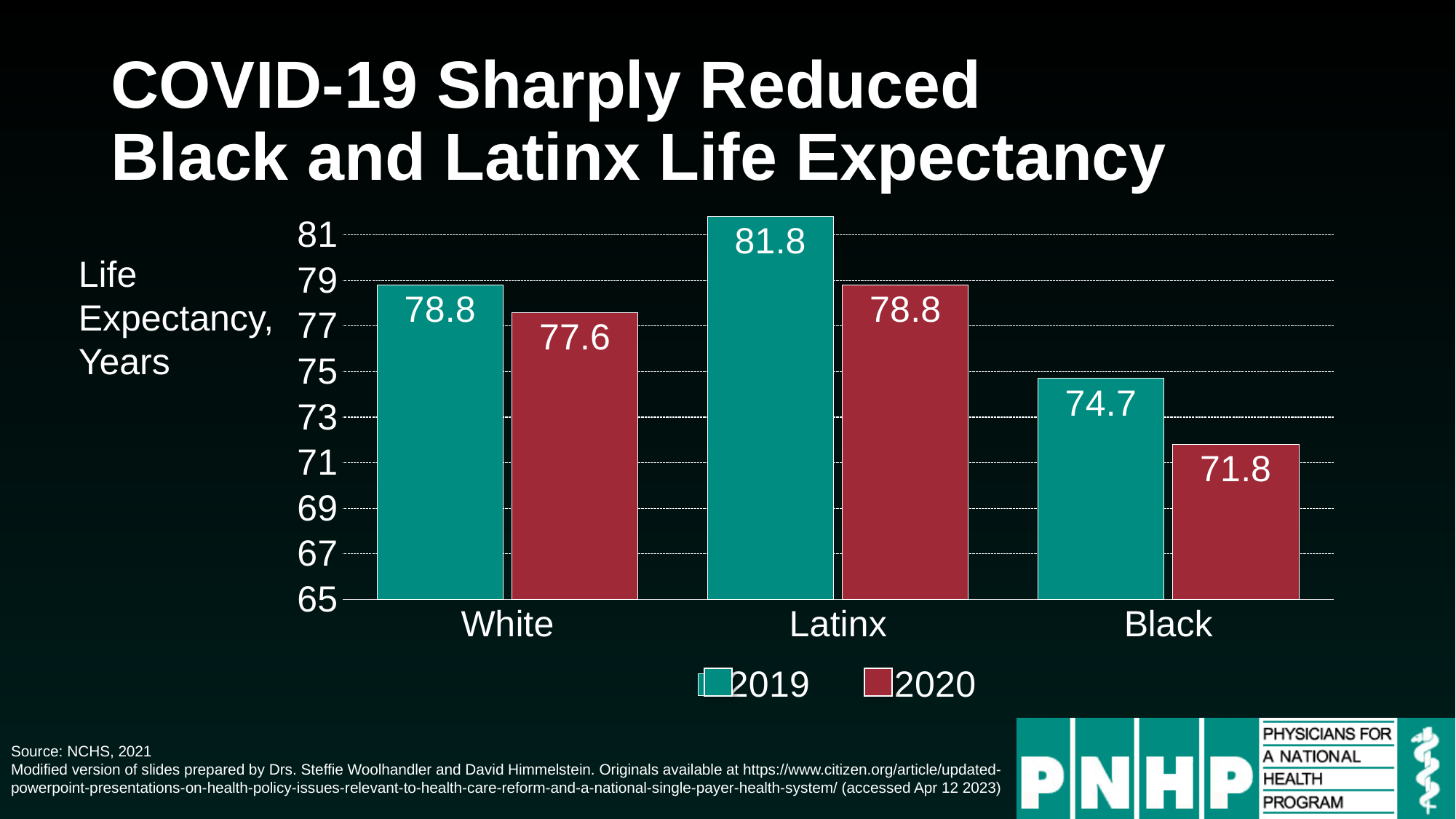
What was the life expectancy for Black people in 2020? 71.8 How many series does the legend list? 2 What kind of chart is shown on the slide? Bar chart What was the life expectancy for Latinx people in 2019? 81.8 By how much did Black life expectancy fall from 2019 to 2020? 2.9 Which group had the highest life expectancy in 2019? Latinx How many groups are shown on the x axis? 3 By how much did Latinx life expectancy fall from 2019 to 2020? 3.0 Which group had the lowest life expectancy in 2020? Black What colour represents the 2020 series? Red What was the life expectancy for White people in 2020? 77.6 Which is larger: White life expectancy in 2019 or Latinx life expectancy in 2020? They are equal (78.8)